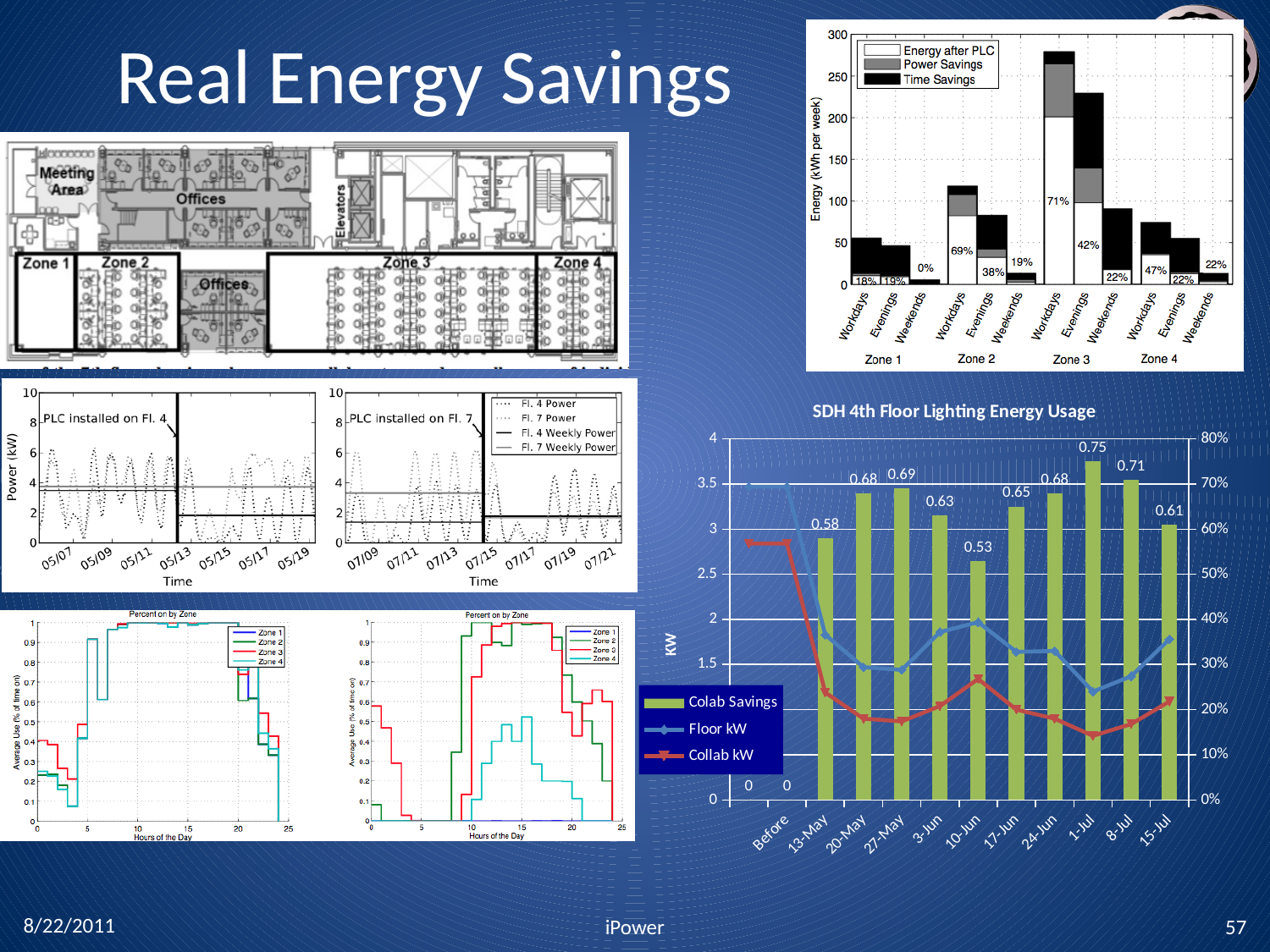
What kind of chart is the SDH 4th Floor Lighting Energy Usage chart? Combined bar and line chart How many series does the legend of the SDH 4th Floor Lighting Energy Usage chart list? 3 In the SDH 4th Floor Lighting Energy Usage chart, which date has the highest Colab Savings? 1-Jul In the SDH 4th Floor Lighting Energy Usage chart, what is the difference between the Colab Savings for 1-Jul and 10-Jun? 0.22 In the SDH 4th Floor Lighting Energy Usage chart, is the Colab Savings value higher for 8-Jul or 15-Jul? 8-Jul In the stacked bar chart at the top right, is the total energy for Zone 3 Workdays greater or less than 250? greater In the stacked bar chart at the top right, what percentage is printed on the Zone 1 Weekends bar? 0% What is the y-axis label of the stacked bar chart at the top right? Energy (kWh per week) In the stacked bar chart at the top right, what percentage is printed on the Zone 3 Workdays bar? 71% In the SDH 4th Floor Lighting Energy Usage chart, what is the Colab Savings value for 1-Jul? 0.75 In the SDH 4th Floor Lighting Energy Usage chart, what is the Colab Savings value for 10-Jun? 0.53 In the SDH 4th Floor Lighting Energy Usage chart, excluding the zero values, which date has the lowest Colab Savings? 10-Jun